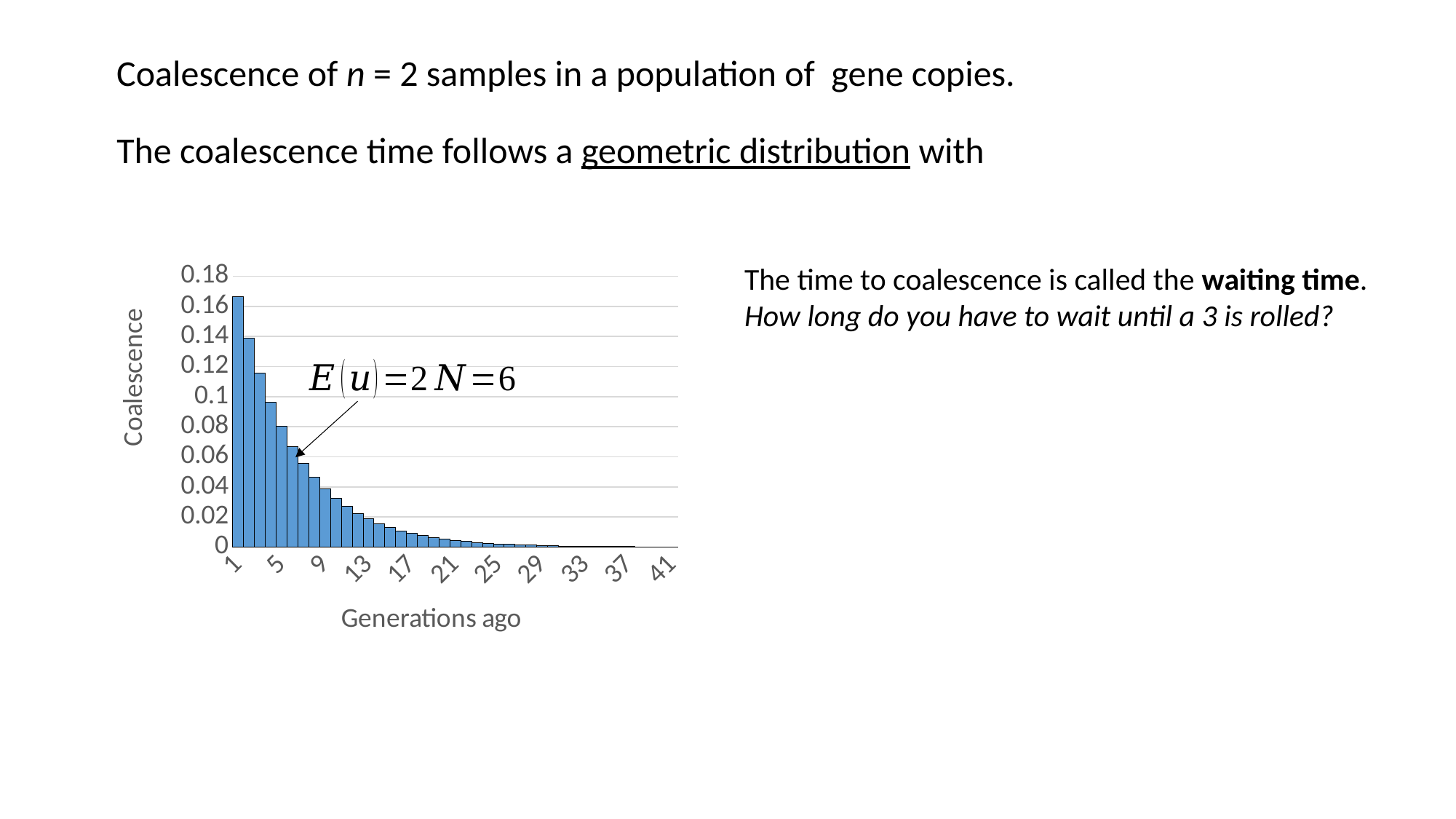
What is the label of the x axis? Generations ago Which has a larger coalescence value, generation 5 or generation 21? generation 5 What is the label of the y axis? Coalescence Is the coalescence value for generation 9 greater or less than 0.06? less Is the coalescence value for generation 5 greater or less than 0.1? less Which has a larger coalescence value, generation 1 or generation 9? generation 1 Which generation has the highest coalescence value? 1 Is the coalescence value for generation 17 greater or less than 0.02? less What kind of chart is shown on the slide? bar chart Do the coalescence values rise or fall as generations ago increases? fall